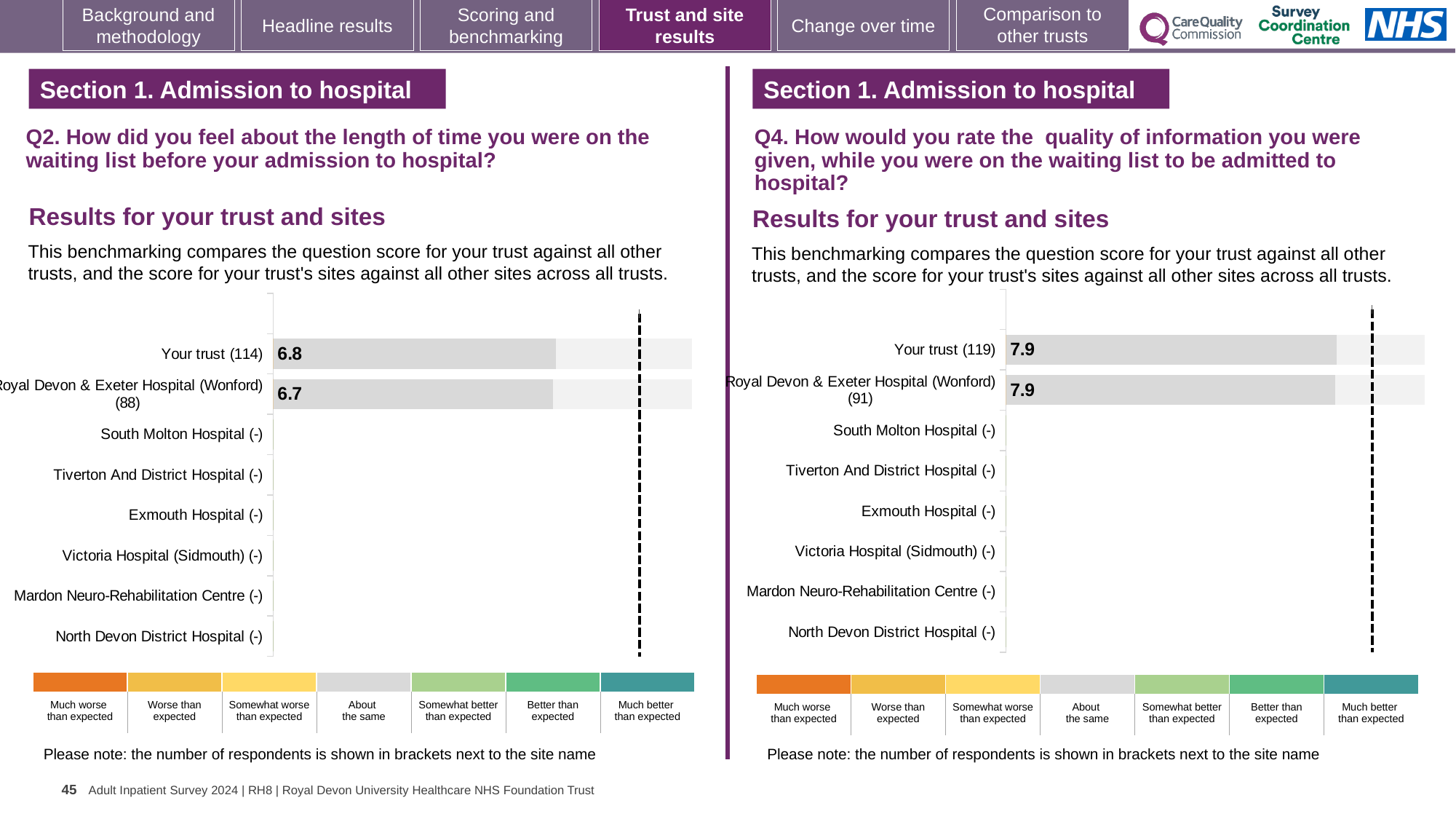
On the Q2 chart (left), what is the difference between the score for Your trust and the score for Royal Devon & Exeter Hospital (Wonford)? 0.1 On the Q2 chart (left), which has the higher score: Your trust or Royal Devon & Exeter Hospital (Wonford)? Your trust On the Q2 chart (left), what is the score for Royal Devon & Exeter Hospital (Wonford)? 6.7 On the Q2 chart (left), how many respondents are shown in brackets for Your trust? 114 What kind of chart is the Q4 chart (right)? Bar chart On the Q4 chart (right), what is the score for Royal Devon & Exeter Hospital (Wonford)? 7.9 How many benchmark categories does the colour key below the Q4 chart (right) list? 7 On the Q4 chart (right), how many respondents are shown in brackets for Royal Devon & Exeter Hospital (Wonford)? 91 How many site/trust categories are listed on the Q2 chart (left)? 8 On the Q4 chart (right), what is the score for Your trust? 7.9 On the Q2 chart (left), how many categories have a plotted bar with a score? 2 On the Q2 chart (left), what is the score for Your trust? 6.8